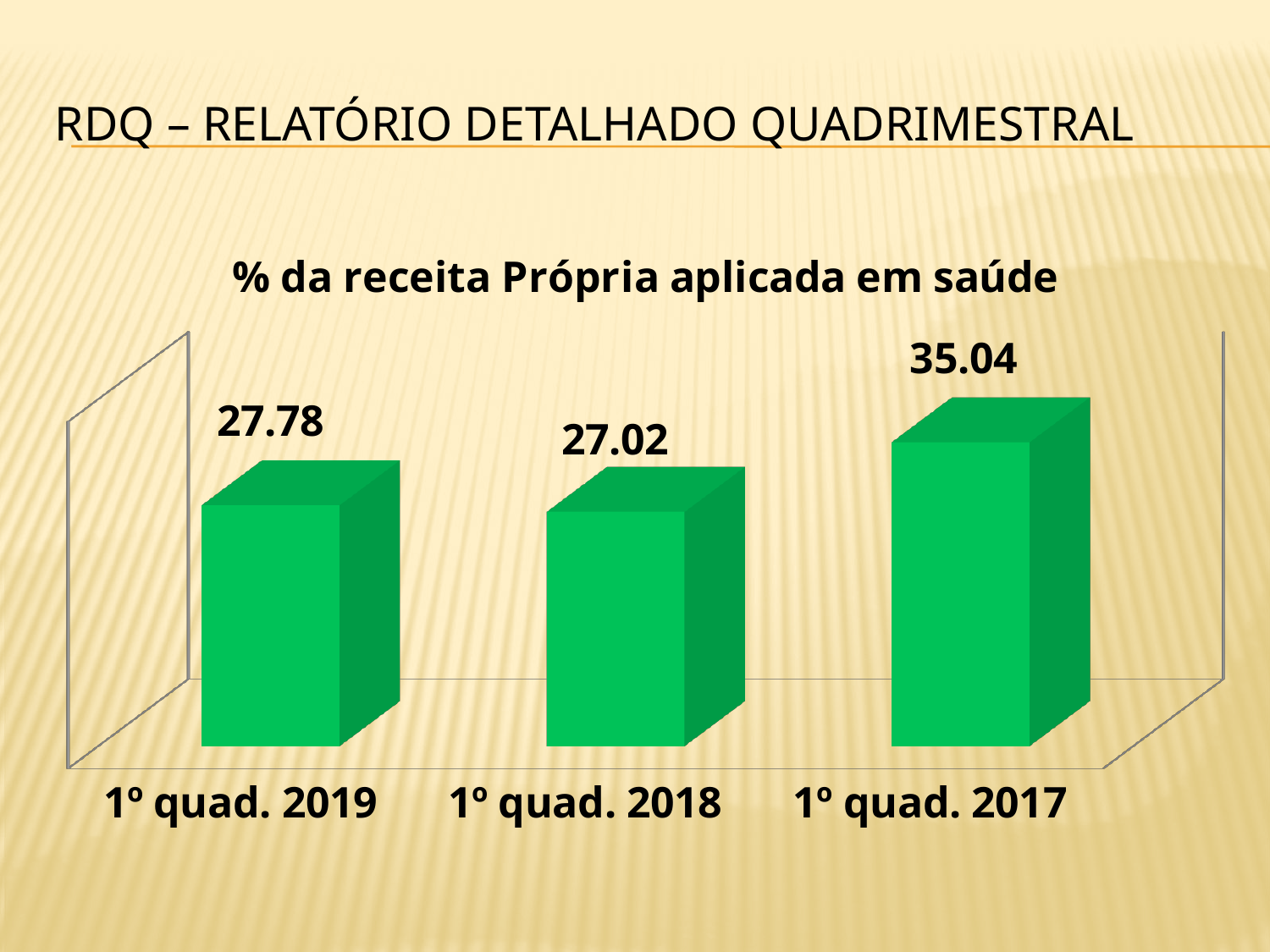
Which category has the highest value? 1º quad. 2017 What kind of chart is shown on the slide? bar chart Which category has the lowest value? 1º quad. 2018 What is the title of the chart? % da receita Própria aplicada em saúde How many categories are shown in the chart? 3 What is the value for 1º quad. 2018? 27.02 What colour are the bars in the chart? green What is the value for 1º quad. 2017? 35.04 What is the difference between the values for 1º quad. 2019 and 1º quad. 2018? 0.76 What is the value for 1º quad. 2019? 27.78 Which is larger, the value for 1º quad. 2017 or the value for 1º quad. 2018? 1º quad. 2017 What is the difference between the values for 1º quad. 2017 and 1º quad. 2019? 7.26